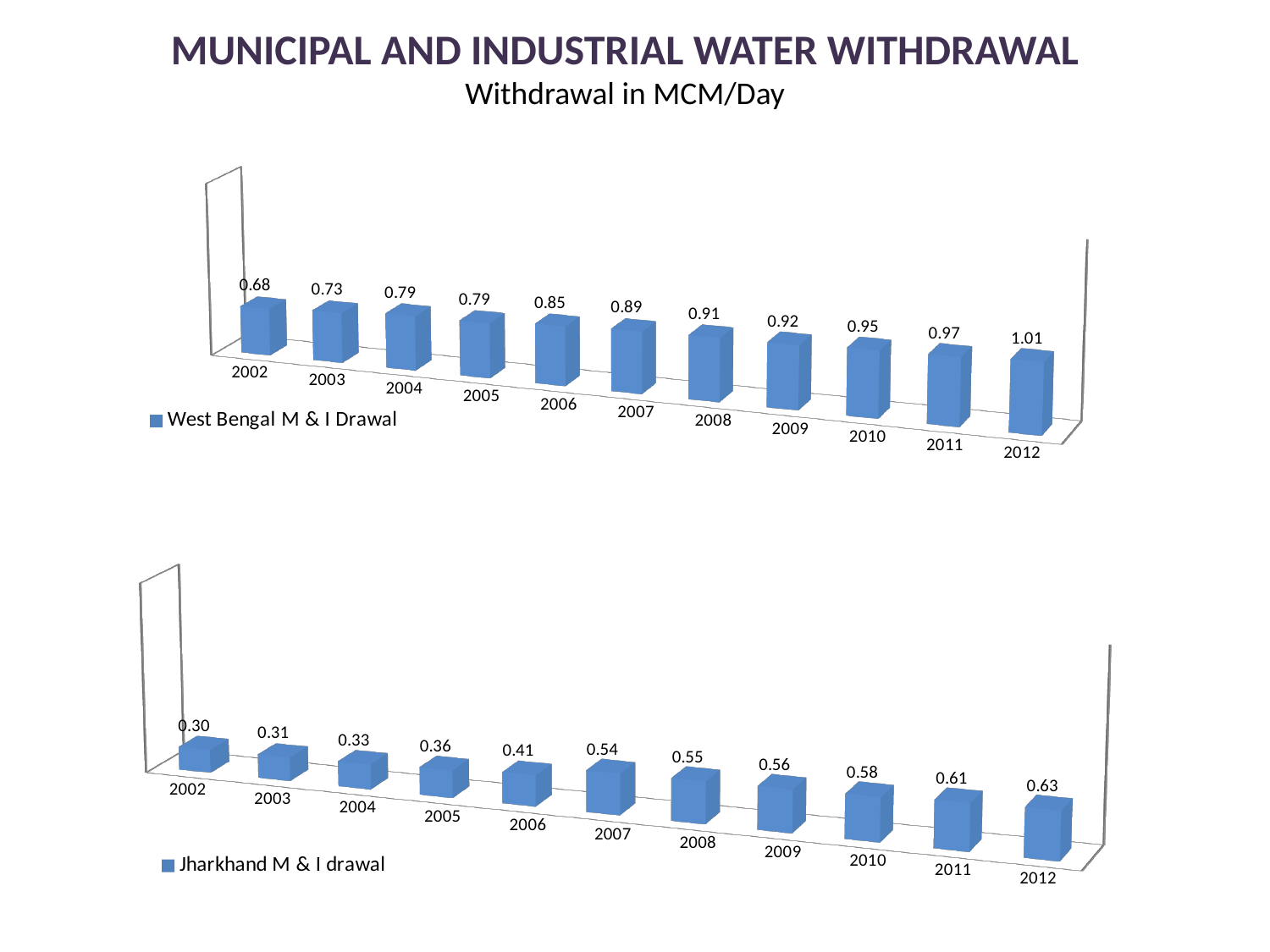
How many years are shown in the top chart (West Bengal M & I Drawal)? 11 How many series does the legend of the bottom chart (Jharkhand M & I drawal) list? 1 In the top chart (West Bengal M & I Drawal), what is the difference between the values for 2012 and 2002? 0.33 In the bottom chart (Jharkhand M & I drawal), what is the difference between the values for 2007 and 2006? 0.13 In the bottom chart (Jharkhand M & I drawal), do the values rise or fall from 2002 to 2012? Rise In the bottom chart (Jharkhand M & I drawal), which year has the lowest value? 2002 In the bottom chart (Jharkhand M & I drawal), which is larger, the value for 2005 or the value for 2009? 2009 What kind of chart is the top chart (West Bengal M & I Drawal)? Bar chart In the bottom chart (Jharkhand M & I drawal), what is the value for 2007? 0.54 In the top chart (West Bengal M & I Drawal), what is the value for 2008? 0.91 In the top chart (West Bengal M & I Drawal), which year has the highest value? 2012 What unit of withdrawal is stated in the slide subtitle? MCM/Day